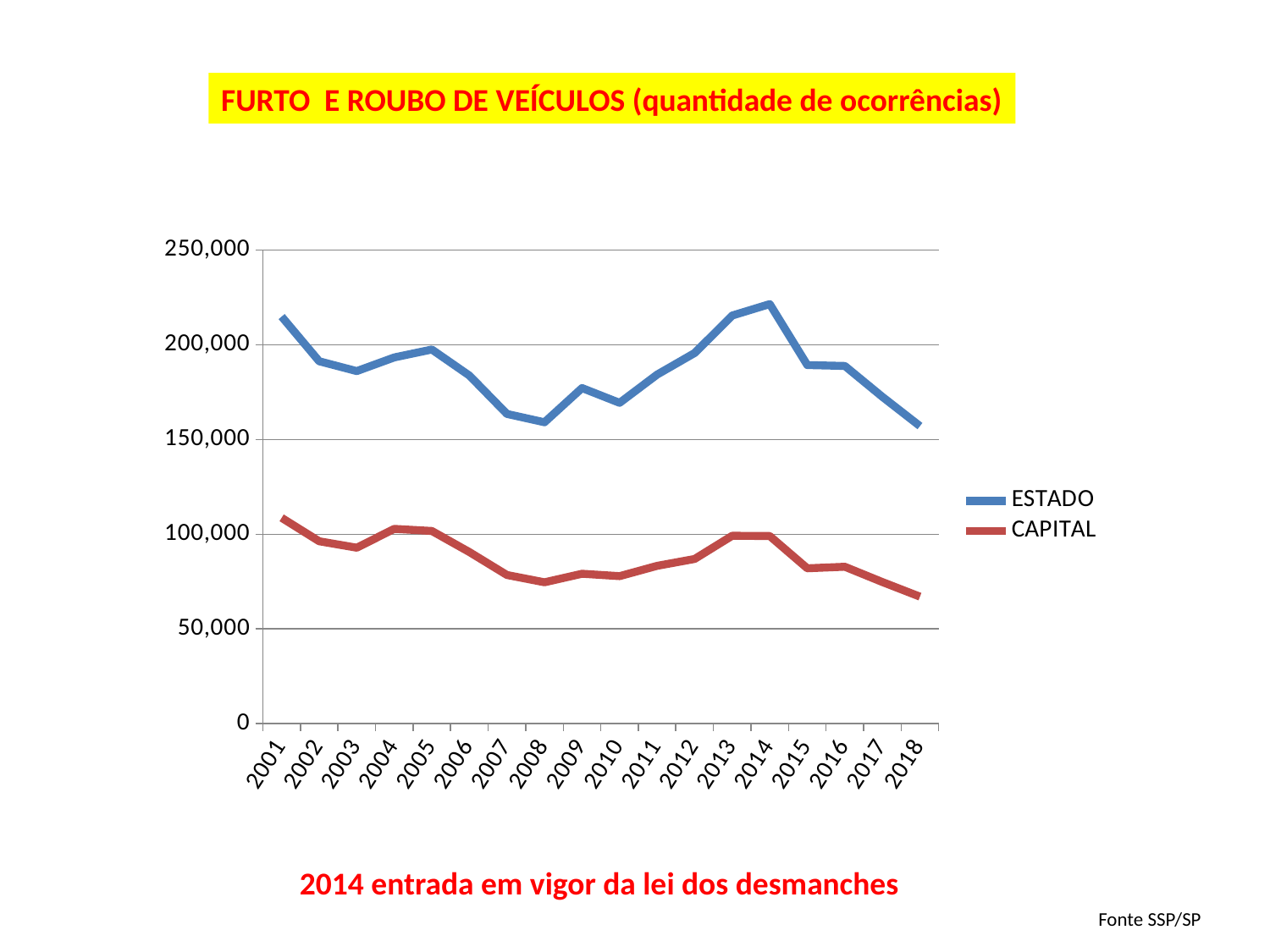
Is the value for ESTADO in 2014 greater or less than 200,000? greater Is the value for CAPITAL in 2018 greater or less than 100,000? less In which year does the ESTADO series reach its highest value? 2014 Is the value for CAPITAL in 2001 greater or less than 100,000? greater Does the CAPITAL series rise or fall from 2014 to 2018? fall How many years are shown along the x axis? 18 Which colour is used for the ESTADO line? blue Which series has the larger value in 2014, ESTADO or CAPITAL? ESTADO In which year does the CAPITAL series reach its lowest value? 2018 How many series does the legend list? 2 What kind of chart is shown on the slide? line chart